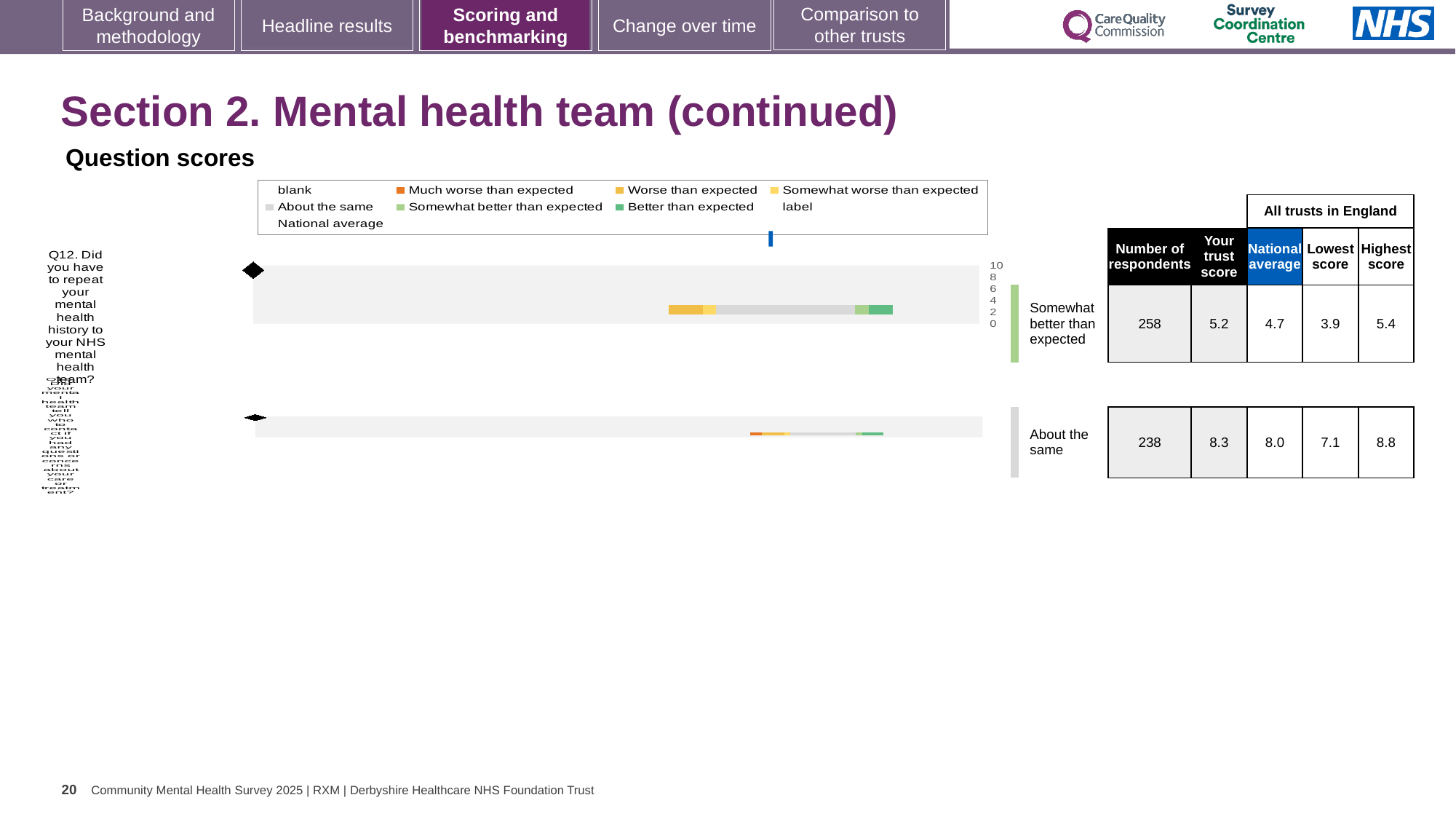
For the Q12 chart, what is the highest score among all trusts in England? 5.4 For the Q12 chart, what is the difference between the highest and lowest scores among all trusts in England? 1.5 For the Q12 chart, which is larger: the trust's score or the national average? the trust's score For the Q12 chart (repeating mental health history), what is the trust's score shown in the table? 5.2 For the Q12 chart, which benchmark category is the trust's result placed in? Somewhat better than expected For the Q12 chart, how many respondents are listed? 258 What kind of chart is used to show the Q12 question score? bar chart For the Q12 chart, what is the national average score? 4.7 For the lower chart on the slide, what is the difference between the trust's score and the national average? 0.3 For the Q12 chart, what is the lowest score among all trusts in England? 3.9 How many question charts are shown on the slide? 2 For the lower chart on the slide, what is the trust's score? 8.3